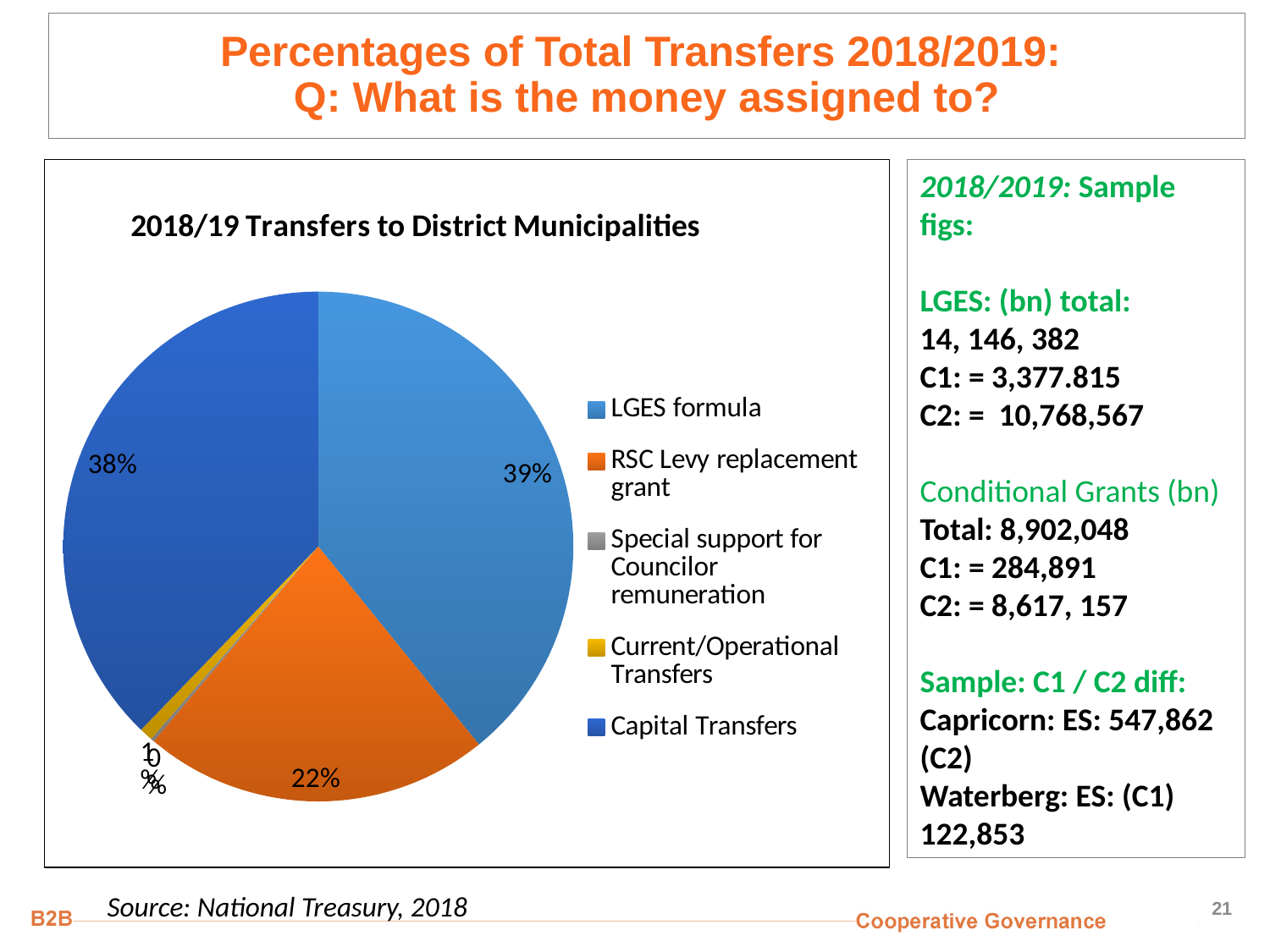
Which is larger, the LGES formula slice or the Capital Transfers slice? LGES formula What percentage of the pie is the RSC Levy replacement grant slice? 22% How many categories does the legend list? 5 What percentage of the pie is the Capital Transfers slice? 38% How many slices does the pie chart have? 5 Which is larger, the RSC Levy replacement grant slice or the Capital Transfers slice? Capital Transfers What percentage of the pie is the LGES formula slice? 39% What is the difference in percentage points between the LGES formula slice and the RSC Levy replacement grant slice? 17 percentage points What kind of chart is shown on the slide? Pie chart Which category has the largest share of the pie? LGES formula What colour is the Capital Transfers slice? Dark blue What is the title of the chart? 2018/19 Transfers to District Municipalities